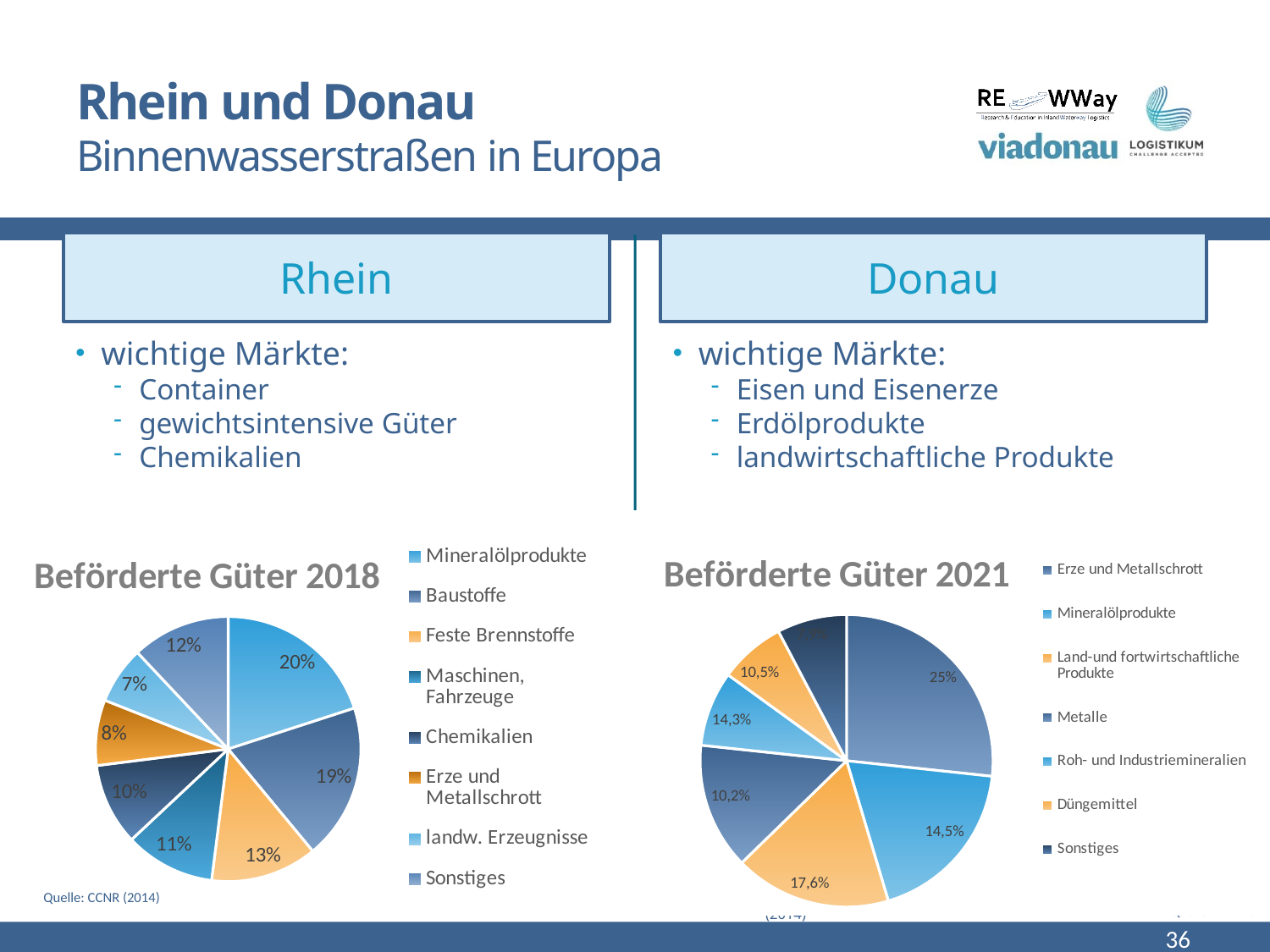
How many slices does the 'Beförderte Güter 2018' pie chart have? 8 In the 'Beförderte Güter 2021' chart, which is larger: the 17,6% slice or the 14,3% slice? 17,6% In the 'Beförderte Güter 2018' chart, what is the smallest slice's share? 7% What kind of chart is 'Beförderte Güter 2018'? pie chart How many categories does the legend of the 'Beförderte Güter 2021' chart list? 7 In the 'Beförderte Güter 2018' chart, what is the difference in percentage points between the largest slice (20%) and the smallest slice (7%)? 13 percentage points In the 'Beförderte Güter 2021' chart, which category has the largest slice? Erze und Metallschrott In the 'Beförderte Güter 2021' chart, what is the largest slice's share? 25% What is the title of the pie chart on the right side of the slide? Beförderte Güter 2021 In the 'Beförderte Güter 2021' chart, what share is shown for Mineralölprodukte? 14,5% In the 'Beförderte Güter 2018' chart, what is the largest slice's share? 20% In the 'Beförderte Güter 2018' chart, what share is shown for Baustoffe? 19%